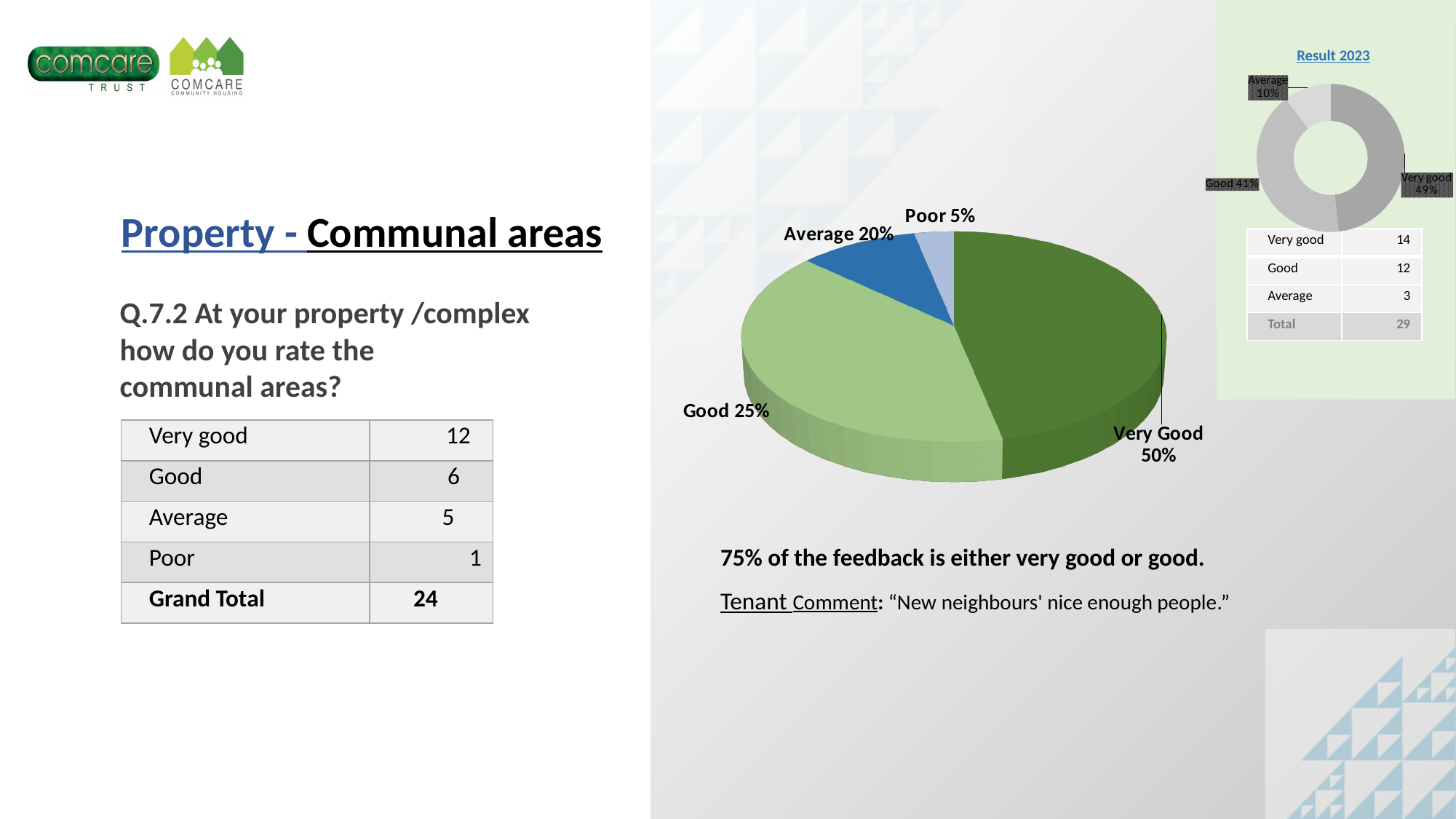
On the large pie chart in the centre of the slide, which category has the largest slice? Very Good On the large pie chart in the centre of the slide, what share is labelled for Poor? 5% On the 'Result 2023' chart in the top right, which category has the largest share? Very good On the large pie chart in the centre of the slide, what share is labelled for Average? 20% On the large pie chart in the centre of the slide, which is larger, the Good slice or the Average slice? Good What kind of chart is the large chart in the centre of the slide? Pie chart On the large pie chart in the centre of the slide, which category has the smallest slice? Poor How many slices does the large pie chart in the centre of the slide have? 4 On the 'Result 2023' chart in the top right, what share is labelled for Good? 41% On the large pie chart in the centre of the slide, what share is labelled for Very Good? 50% What is the title of the small donut chart in the top right of the slide? Result 2023 On the large pie chart in the centre of the slide, what is the difference between the Good and Average shares? 5%